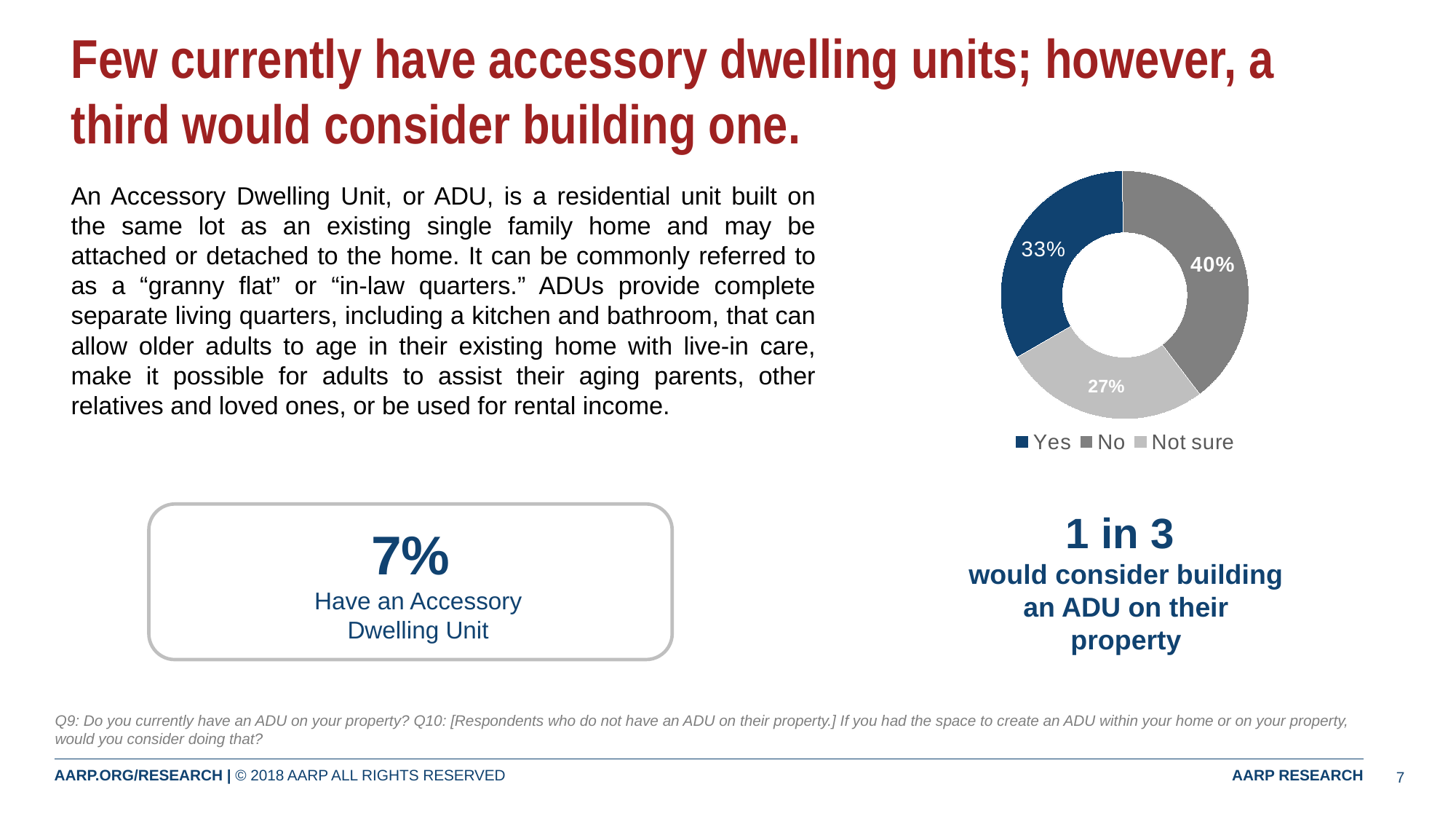
What percentage of respondents answered "No" in the donut chart? 40% How many categories does the donut chart show? 3 What percentage of respondents answered "Not sure" in the donut chart? 27% What is the difference in percentage points between the "No" and "Yes" shares in the donut chart? 7 What colour is the "Yes" slice in the donut chart? Dark blue What are the legend entries of the donut chart, in order? Yes, No, Not sure What percentage of respondents answered "Yes" in the donut chart? 33% What is the difference in percentage points between the "Yes" and "Not sure" shares in the donut chart? 6 Which is larger in the donut chart, the "Yes" share or the "Not sure" share? Yes Which response has the smallest share in the donut chart? Not sure Which response has the largest share in the donut chart? No What kind of chart is shown on the slide? Donut (pie) chart